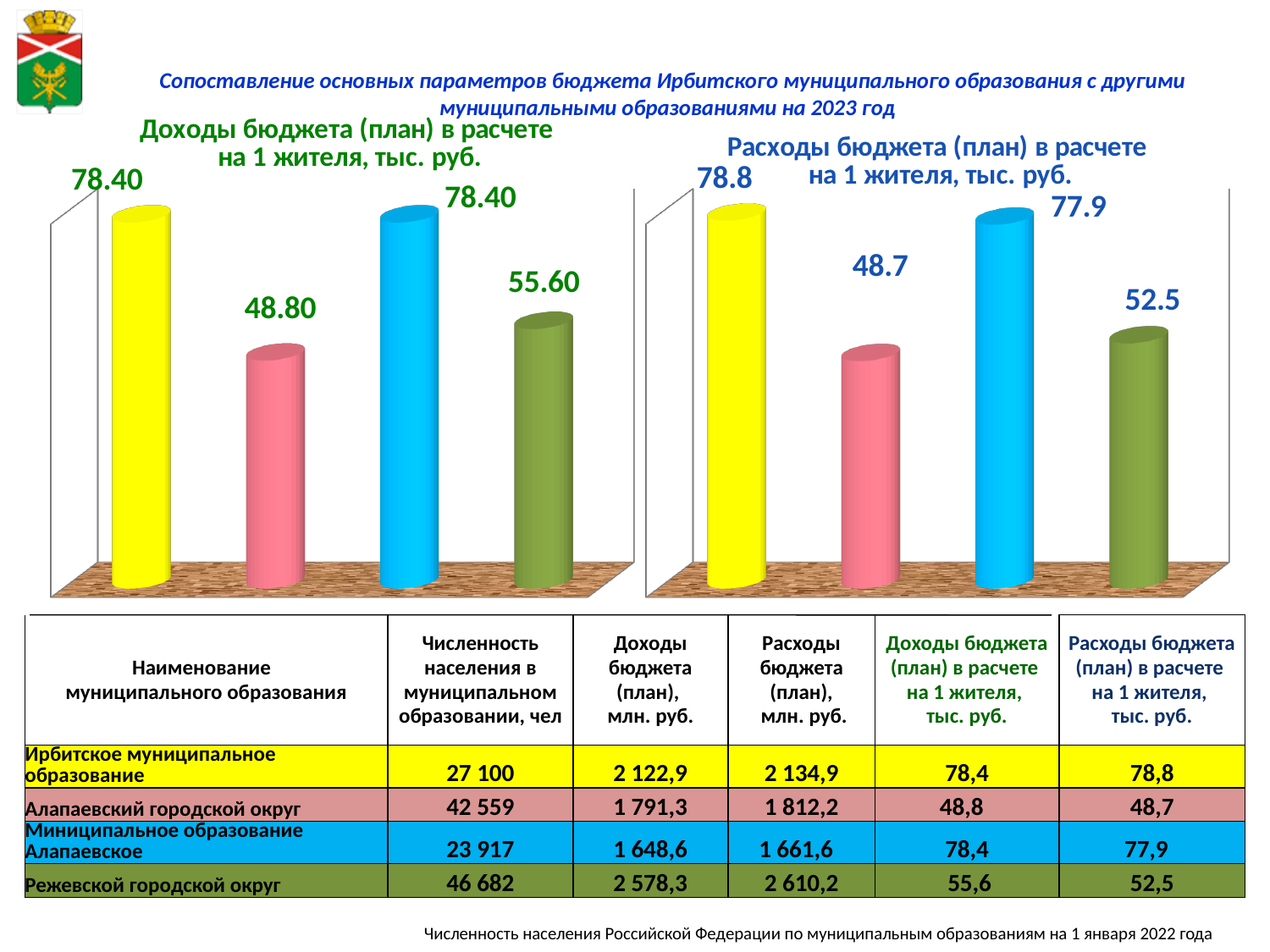
In the left chart (Доходы бюджета (план) в расчете на 1 жителя), which bar has the lowest value? The pink bar (48.80) In the right chart (Расходы бюджета (план) в расчете на 1 жителя), which bar has the highest value? The yellow bar (78.8) In the left chart (Доходы бюджета (план) в расчете на 1 жителя), what is the difference between the green bar and the pink bar? 6.80 In the left chart (Доходы бюджета (план) в расчете на 1 жителя), what is the value shown on the pink bar? 48.80 In the right chart (Расходы бюджета (план) в расчете на 1 жителя), what is the value shown on the blue bar? 77.9 In the right chart (Расходы бюджета (план) в расчете на 1 жителя), what is the difference between the yellow bar and the pink bar? 30.1 What is the title of the left chart? Доходы бюджета (план) в расчете на 1 жителя, тыс. руб. How many bars are plotted in the left chart (Доходы бюджета (план) в расчете на 1 жителя)? 4 What type of chart is used for Расходы бюджета (план) в расчете на 1 жителя? Bar chart In the left chart (Доходы бюджета (план) в расчете на 1 жителя), what is the value shown on the first (yellow) bar? 78.40 In the right chart (Расходы бюджета (план) в расчете на 1 жителя), which is larger: the green bar or the pink bar? The green bar (52.5) In the right chart (Расходы бюджета (план) в расчете на 1 жителя), what is the value shown on the green bar? 52.5